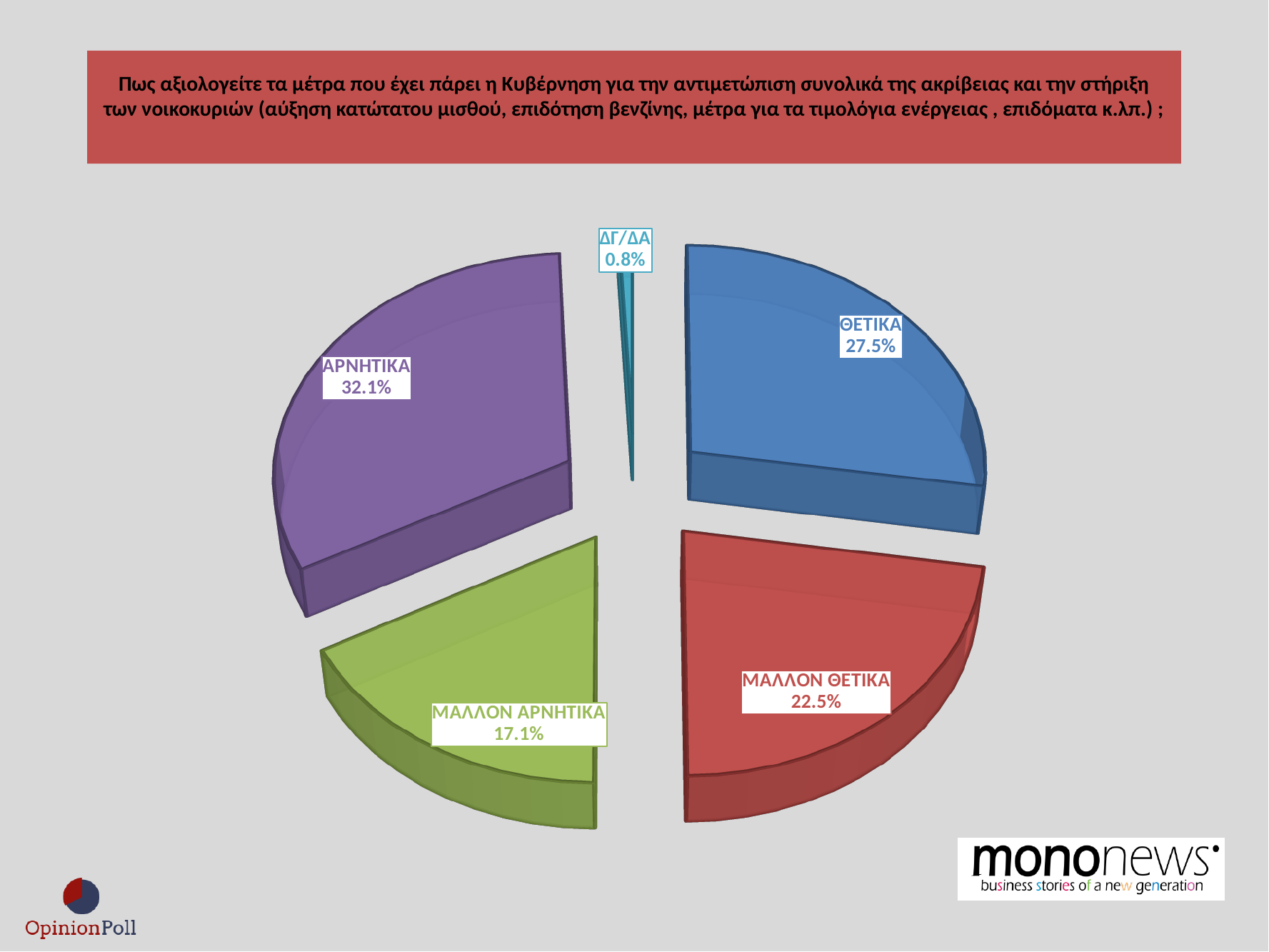
What percentage of respondents answered ΑΡΝΗΤΙΚΑ? 32.1% What percentage of respondents answered ΔΓ/ΔΑ? 0.8% What percentage of respondents answered ΘΕΤΙΚΑ? 27.5% Which is larger, the share for ΜΑΛΛΟΝ ΘΕΤΙΚΑ or the share for ΜΑΛΛΟΝ ΑΡΝΗΤΙΚΑ? ΜΑΛΛΟΝ ΘΕΤΙΚΑ Which response category has the smallest share of the pie? ΔΓ/ΔΑ What percentage of respondents answered ΜΑΛΛΟΝ ΘΕΤΙΚΑ? 22.5% How many slices does the pie chart have? 5 What percentage of respondents answered ΜΑΛΛΟΝ ΑΡΝΗΤΙΚΑ? 17.1% What colour is the ΑΡΝΗΤΙΚΑ slice? Purple Which response category has the largest share of the pie? ΑΡΝΗΤΙΚΑ What is the difference in percentage points between ΑΡΝΗΤΙΚΑ and ΘΕΤΙΚΑ? 4.6 What kind of chart is shown on the slide? Pie chart